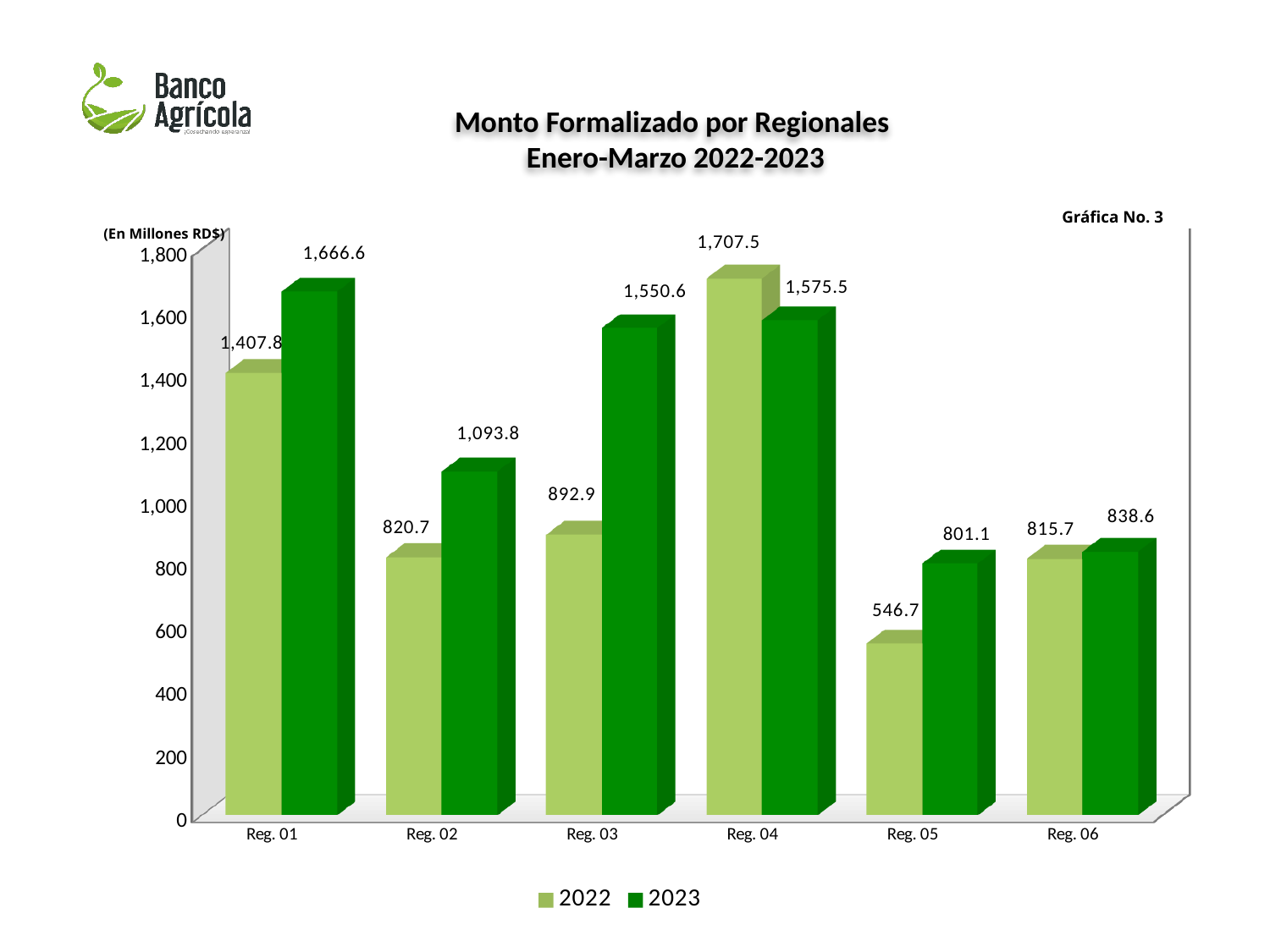
What is the value for Reg. 01 in the 2023 series? 1,666.6 In what units are the values on the chart expressed, according to the label above the y axis? En Millones RD$ What kind of chart is shown on the slide? Bar chart For Reg. 04, which series has the larger value, 2022 or 2023? 2022 Which region has the lowest value in the 2023 series? Reg. 05 What is the value for Reg. 03 in the 2023 series? 1,550.6 Which region has the highest value in the 2022 series? Reg. 04 How many series does the legend list? 2 What is the difference between the 2023 and 2022 values for Reg. 01? 258.8 What is the value for Reg. 05 in the 2022 series? 546.7 How many regions are shown on the x axis? 6 What is the difference between the 2022 and 2023 values for Reg. 04? 132.0